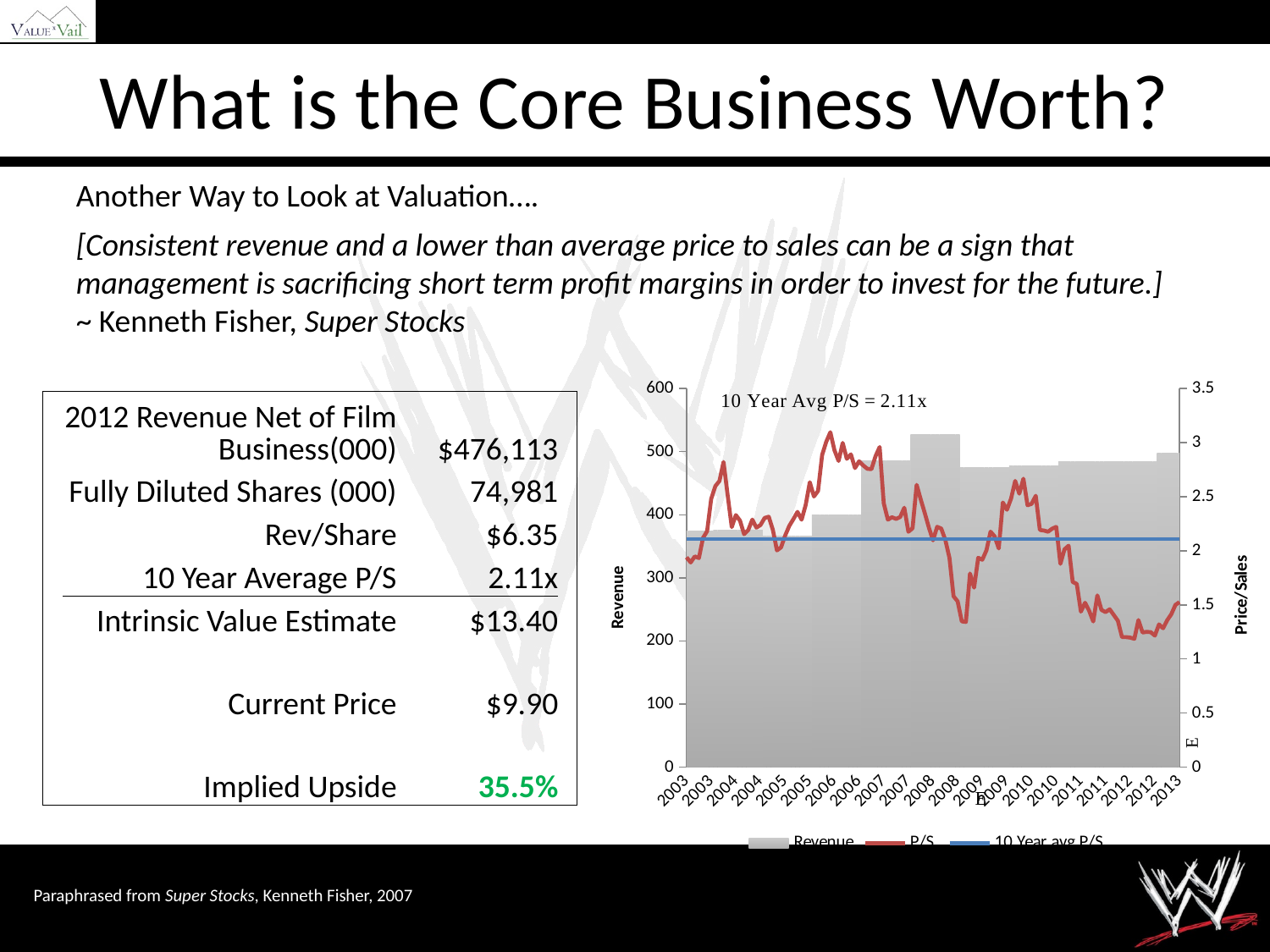
Which is higher, the P/S in 2006 or the P/S in 2012? 2006 How many series does the chart legend list? 3 What is the label of the right-hand vertical axis? Price/Sales Which series is drawn as the red line? P/S Is the P/S value in 2012 greater or less than 1.5? less Is the revenue value for 2003 greater or less than 400? less Does the P/S line rise or fall from 2010 to 2012? fall What kind of chart is shown on the slide? combination bar and line chart What value does the chart's annotation give for the 10 year average P/S? 2.11x Is the revenue value for 2008 greater or less than 500? greater